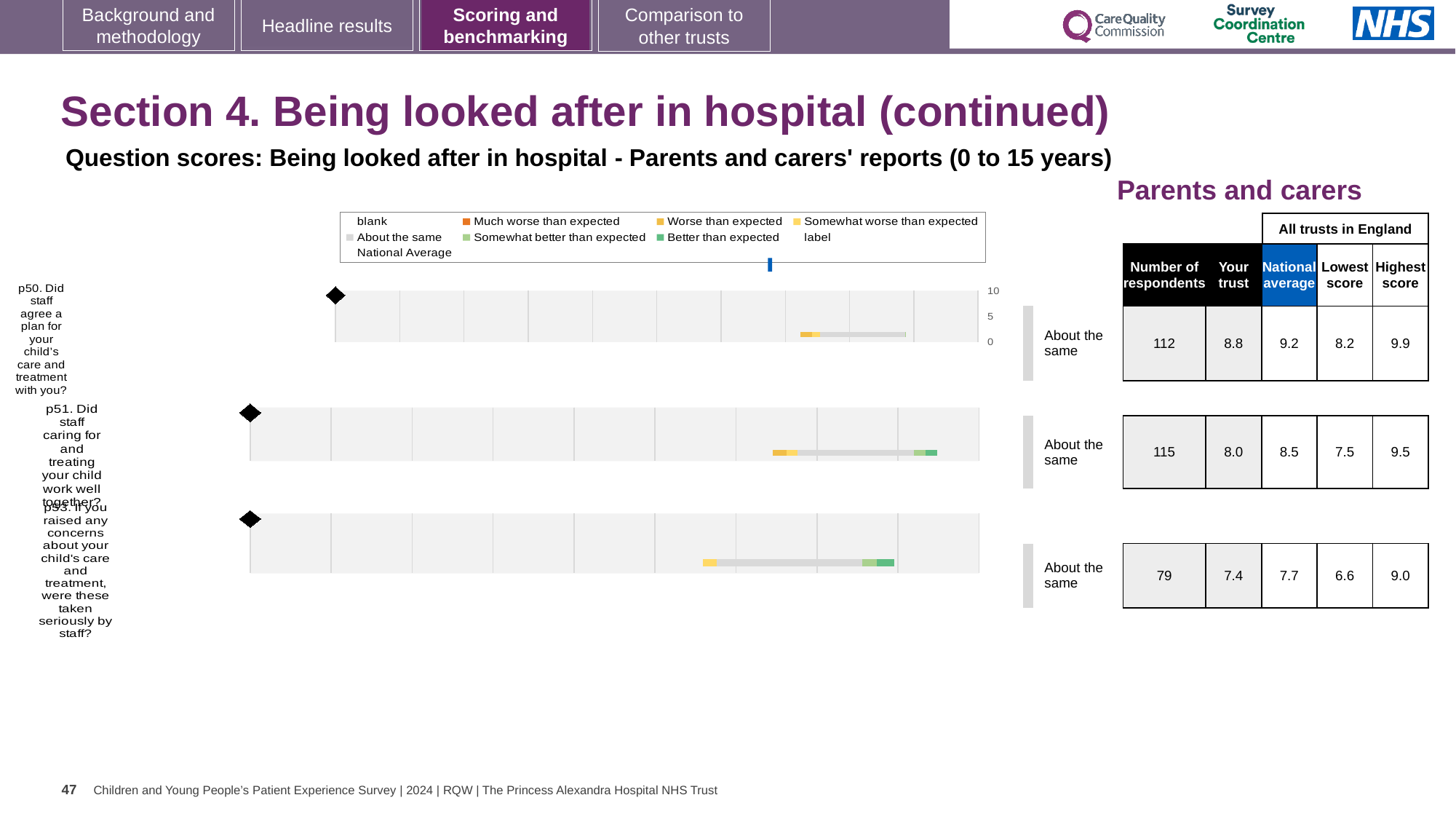
What is the 'Your trust' score for question p50 (Did staff agree a plan for your child's care and treatment with you?)? 8.8 What is the highest score across all trusts in England for question p50? 9.9 What kind of chart is used to show the question scores on this slide? Bar chart How many respondents are shown for question p53 (If you raised any concerns about your child's care and treatment, were these taken seriously by staff?)? 79 How many questions are plotted on this slide? 3 What is the lowest score across all trusts in England for question p53? 6.6 What benchmark rating is shown for question p51? About the same Which question has the lowest number of respondents on this slide? p53 Which has the larger 'Your trust' score: question p51 or question p53? p51 For question p53, what is the difference between the national average and the 'Your trust' score? 0.3 Which question has the highest 'Your trust' score on this slide? p50 What is the national average score for question p51 (Did staff caring for and treating your child work well together?)? 8.5